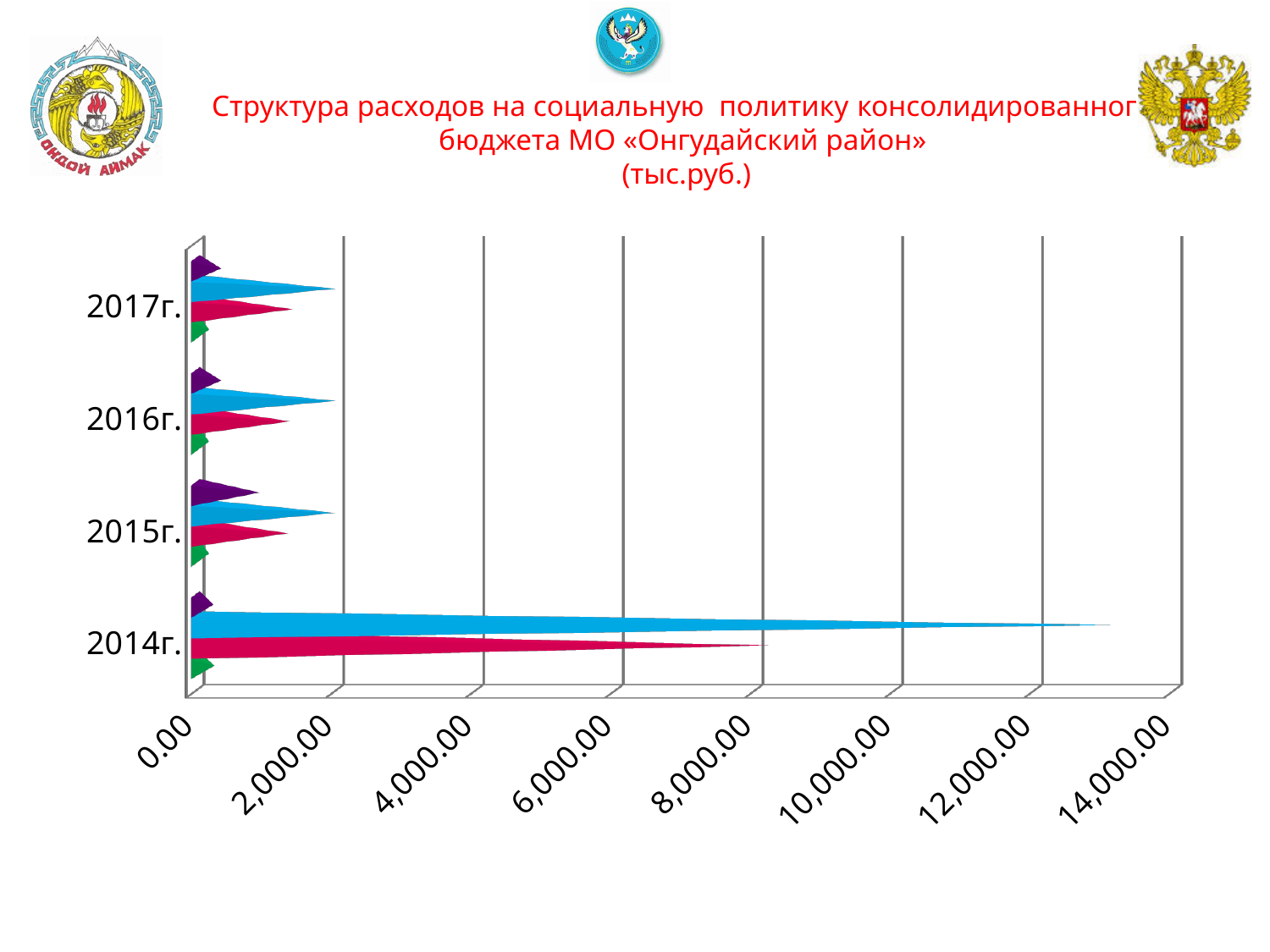
For 2015г., which is larger: the blue series or the green series? the blue series Is the value of the blue series for 2014г. greater or less than 12,000.00? greater Is the value of the pink series for 2014г. greater or less than 6,000.00? greater Is the value of the pink series for 2017г. greater or less than 2,000.00? less Which year has the highest value for the blue series? 2014г. What kind of chart is shown on the slide? bar chart Which year has the highest value for the purple series? 2015г. How many years (categories) are shown on the chart? 4 Which year has the highest value for the pink series? 2014г. What unit is given in the chart title? тыс.руб. For 2014г., which is larger: the blue series or the pink series? the blue series